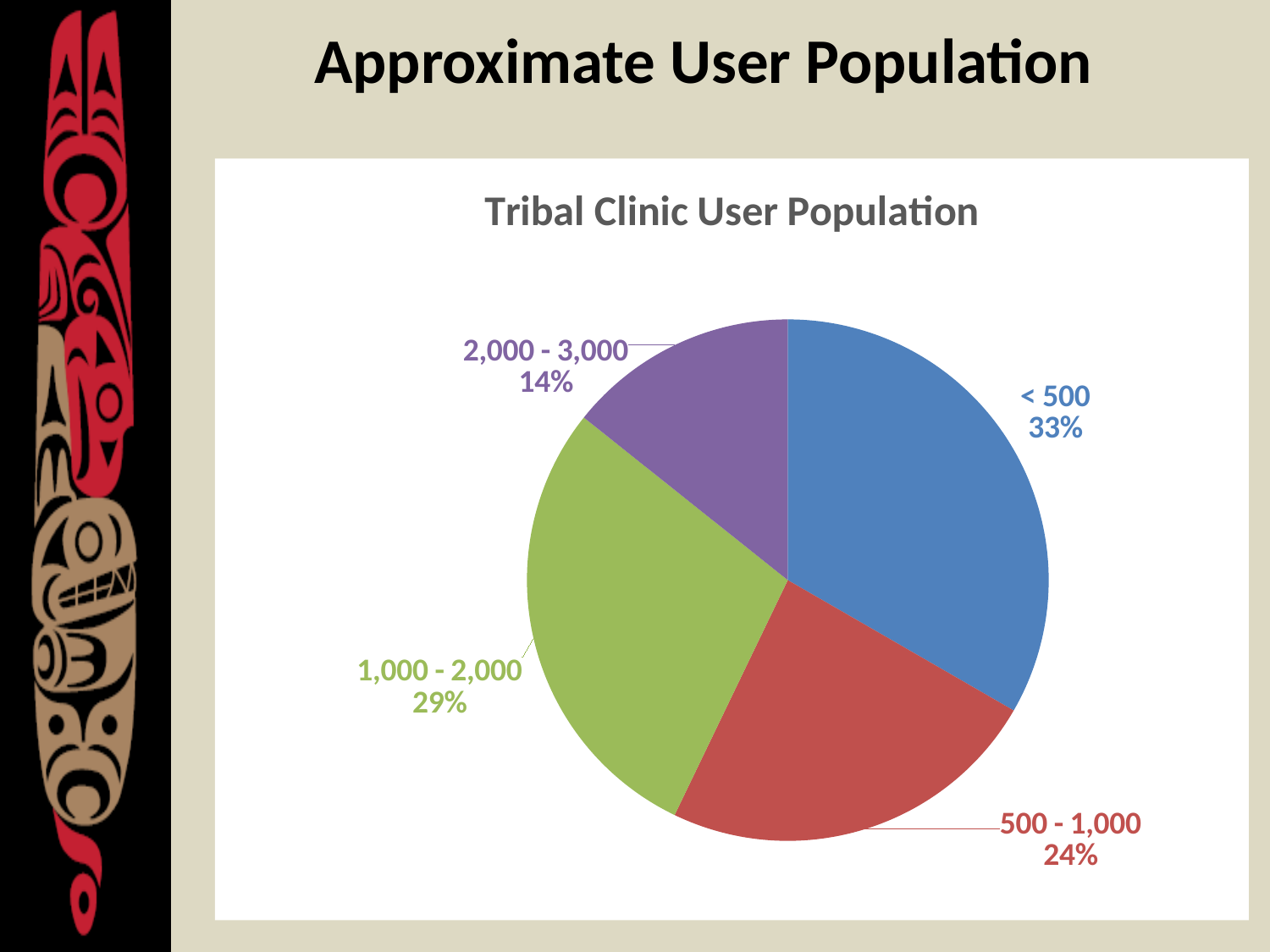
What is the title of the chart? Tribal Clinic User Population Which category has the smallest share of the pie? 2,000 - 3,000 What kind of chart is shown on the slide? pie chart What colour is the 1,000 - 2,000 slice? green What percentage of the pie is the 1,000 - 2,000 slice? 29% What is the difference in percentage points between the < 500 slice and the 2,000 - 3,000 slice? 19 What percentage of the pie is the 500 - 1,000 slice? 24% What percentage of the pie is the < 500 slice? 33% Which slice is larger, 500 - 1,000 or 1,000 - 2,000? 1,000 - 2,000 Which category has the largest share of the pie? < 500 What percentage of the pie is the 2,000 - 3,000 slice? 14% How many slices does the pie chart have? 4